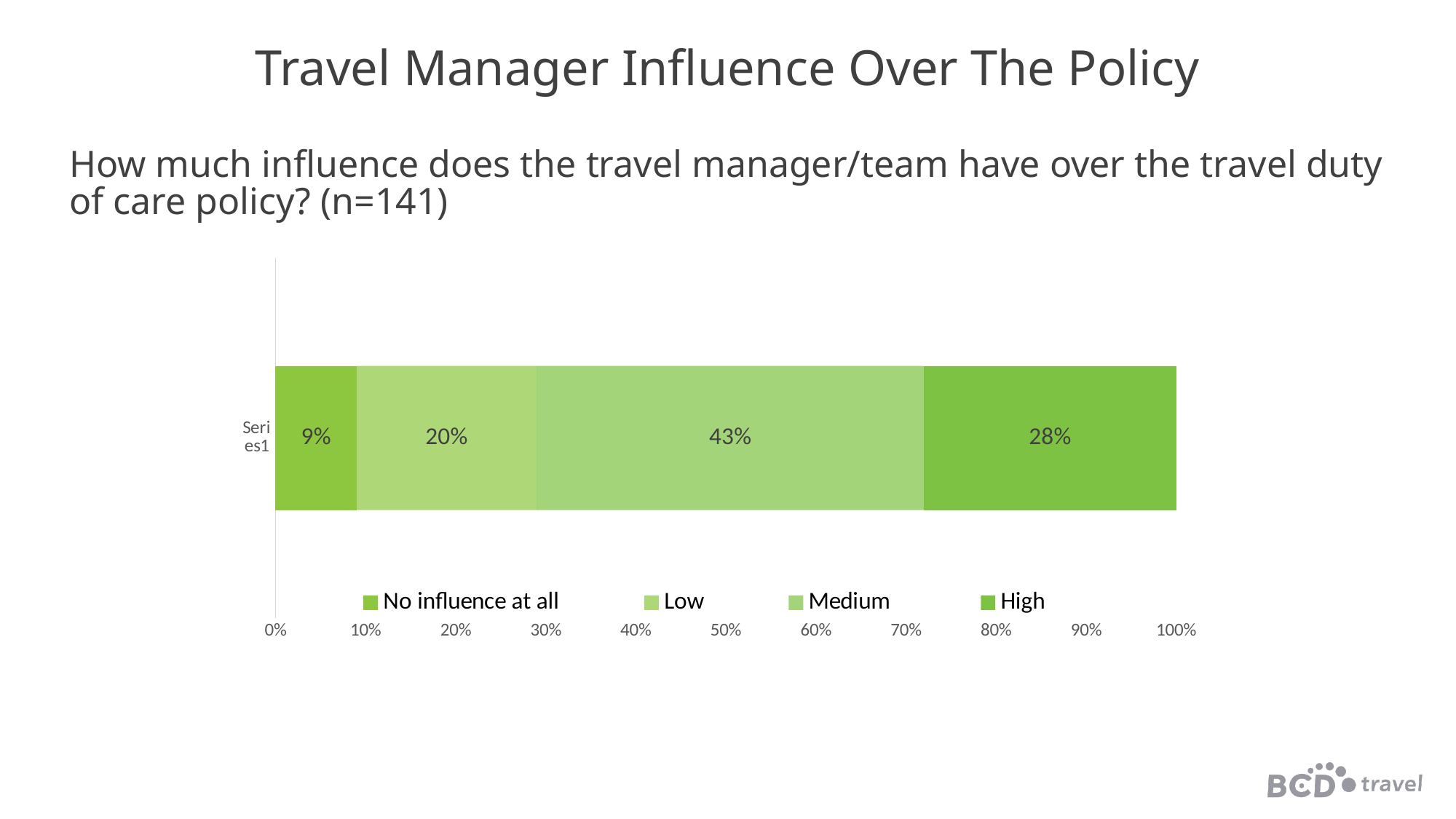
What percentage of respondents said the travel manager/team has no influence at all over the travel duty of care policy? 9% How many series does the legend list? 4 What is the combined share of respondents reporting Medium or High influence? 71% Which is larger, the share for Low or the share for High? High What is the difference in percentage points between the Medium and High shares? 15 What percentage of respondents reported a High level of influence? 28% What is the sample size (n) stated in the question above the chart? 141 Which influence level has the smallest share of respondents? No influence at all Which influence level has the largest share of respondents? Medium What percentage of respondents reported a Low level of influence? 20% What percentage of respondents reported a Medium level of influence? 43% What kind of chart is shown on the slide? Stacked bar chart